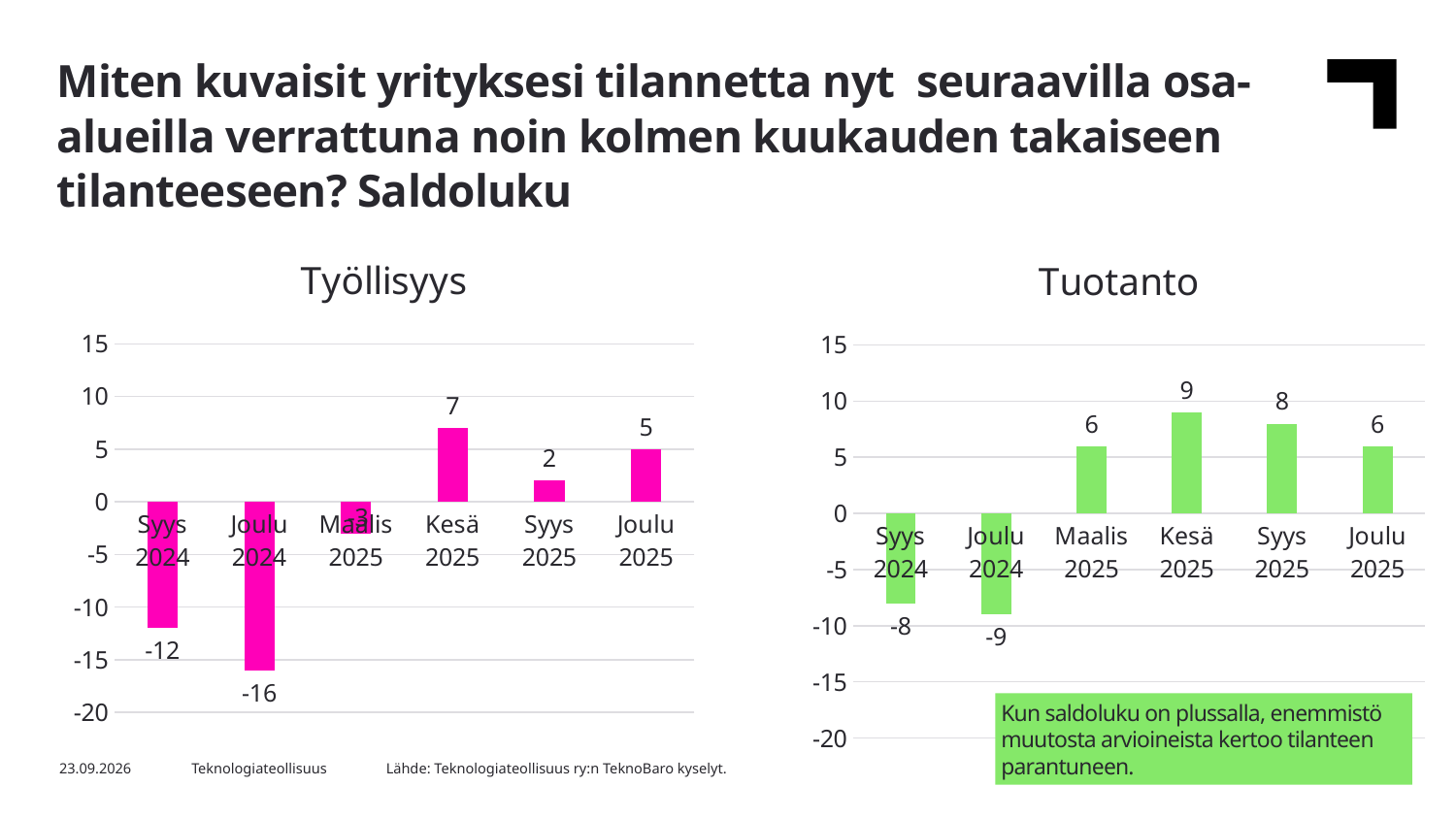
In the Tuotanto chart, which is larger, the value for Syys 2025 or Joulu 2025? Syys 2025 In the Työllisyys chart, which period has the lowest value? Joulu 2024 In the Tuotanto chart, what is the value for Joulu 2024? -9 How many periods are shown on the x axis of the Tuotanto chart? 6 What type of chart is the Työllisyys chart? Bar chart In the Työllisyys chart, which period has the highest value? Kesä 2025 In the Tuotanto chart, which period has the highest value? Kesä 2025 In the Työllisyys chart, what is the value for Kesä 2025? 7 In the Tuotanto chart, what is the difference between the values for Kesä 2025 and Maalis 2025? 3 In the Tuotanto chart, what is the value for Kesä 2025? 9 In the Työllisyys chart, what is the difference between the values for Kesä 2025 and Syys 2025? 5 In the Työllisyys chart, what is the value for Joulu 2024? -16